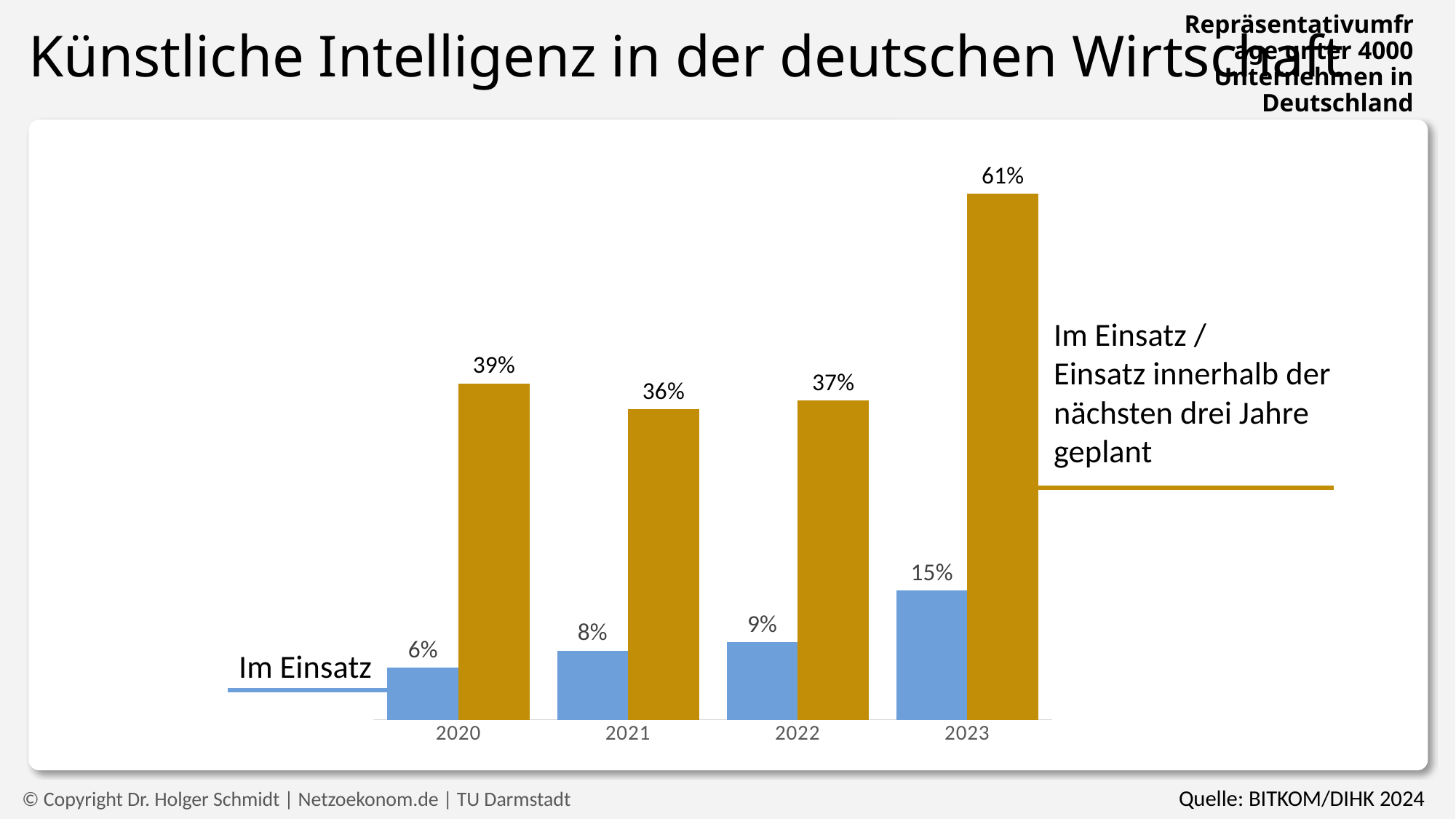
Does the 'Im Einsatz' series rise or fall from 2020 to 2023? Rise What is the value of the 'Im Einsatz' series for 2023? 15% In which year is the 'Im Einsatz / Einsatz innerhalb der nächsten drei Jahre geplant' series highest? 2023 How many data series does the chart show? 2 In which year is the 'Im Einsatz' series lowest? 2020 What kind of chart is shown on the slide? Bar chart Which is larger: the 'Im Einsatz / Einsatz innerhalb der nächsten drei Jahre geplant' value for 2020 or for 2022? 2020 What is the value of the 'Im Einsatz / Einsatz innerhalb der nächsten drei Jahre geplant' series for 2021? 36% How many years are shown on the x axis? 4 What is the difference between the 'Im Einsatz' values for 2023 and 2022? 6% What is the difference between the two series' values for 2023? 46% What is the value of the 'Im Einsatz' series for 2020? 6%